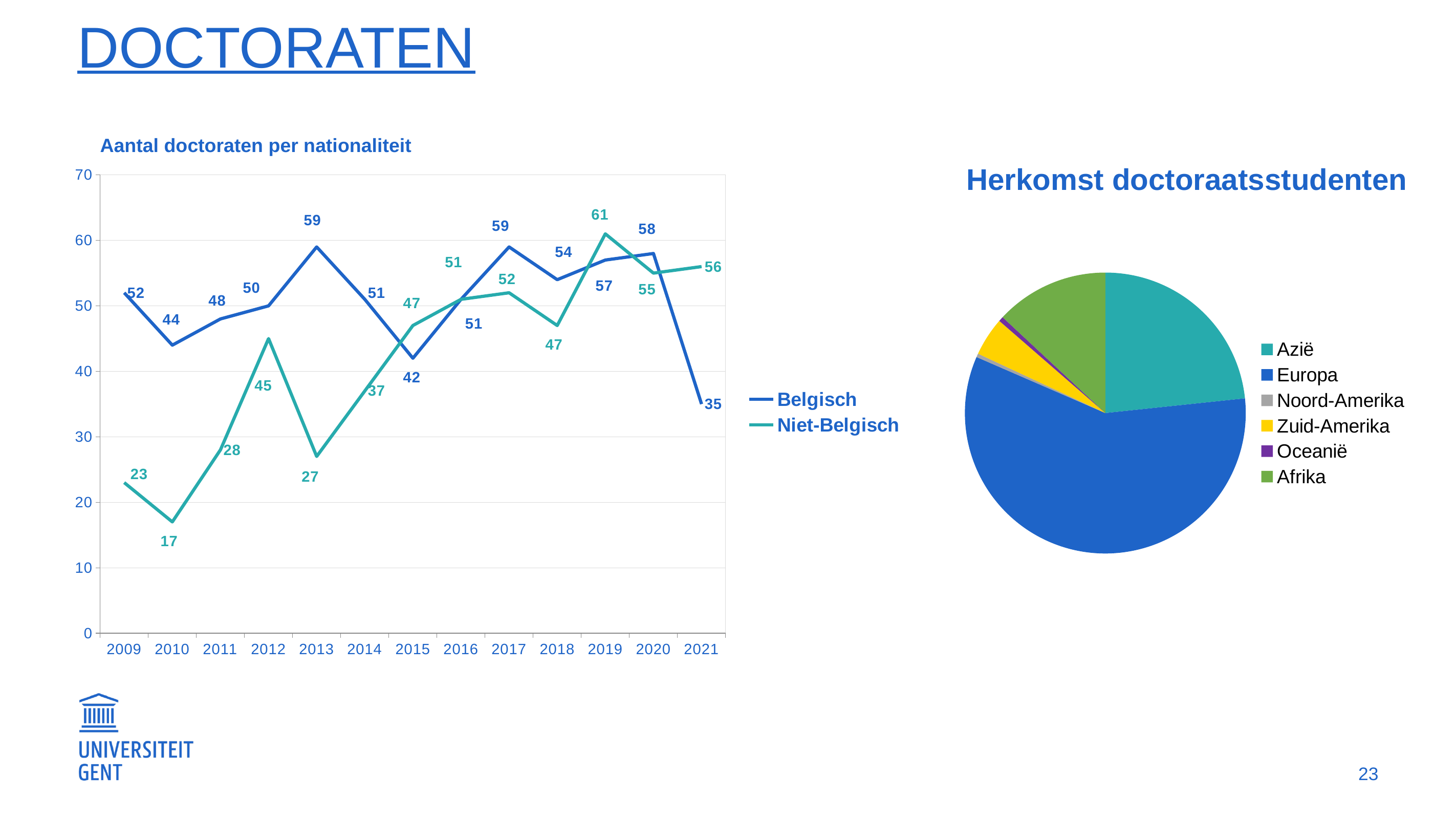
In the 'Aantal doctoraten per nationaliteit' chart, in which year is the Belgisch value lowest? 2021 In the 'Aantal doctoraten per nationaliteit' chart, what is the value for Belgisch in 2013? 59 In the 'Aantal doctoraten per nationaliteit' chart, how many series does the legend list? 2 In the 'Aantal doctoraten per nationaliteit' chart, what is the value for Niet-Belgisch in 2010? 17 In the 'Herkomst doctoraatsstudenten' pie chart, which category has the largest slice? Europa In the 'Aantal doctoraten per nationaliteit' chart, which series has the larger value in 2021, Belgisch or Niet-Belgisch? Niet-Belgisch How many categories does the legend of the 'Herkomst doctoraatsstudenten' pie chart list? 6 In the 'Aantal doctoraten per nationaliteit' chart, what is the value for Niet-Belgisch in 2019? 61 In the 'Aantal doctoraten per nationaliteit' chart, what is the difference between the Belgisch and Niet-Belgisch values in 2009? 29 In the 'Aantal doctoraten per nationaliteit' chart, in which year is the Niet-Belgisch value highest? 2019 What kind of chart is 'Aantal doctoraten per nationaliteit'? Line chart In the 'Aantal doctoraten per nationaliteit' chart, how many years are shown on the x axis? 13